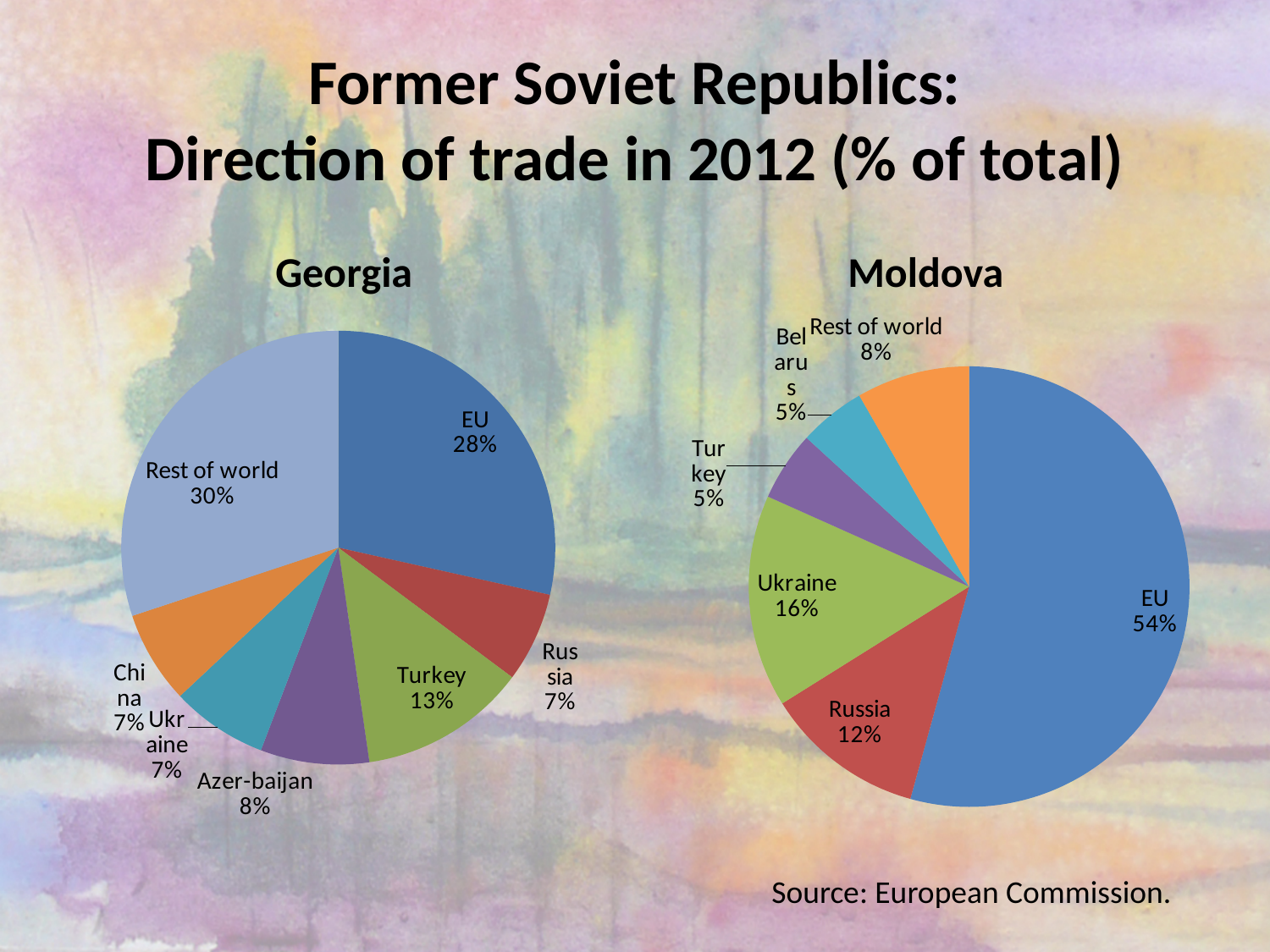
In the Georgia chart, which category has the largest share? Rest of world How many slices does the Georgia pie chart have? 7 In the Moldova chart, what share of trade goes to Ukraine? 16% What type of chart is used for Georgia and Moldova on this slide? Pie chart According to the slide, what is the source of the data? European Commission How many slices does the Moldova pie chart have? 6 In the Georgia chart, what is the share for Turkey? 13% In the Georgia chart, what is the difference between the Rest of world share and the EU share? 2% In the Moldova chart, what is the difference between the EU share and the Russia share? 42% Which is larger: Russia's share in the Georgia chart or Russia's share in the Moldova chart? Moldova In the Georgia chart, what share of trade goes to the EU? 28% In the Moldova chart, which trading partner has the largest share? EU